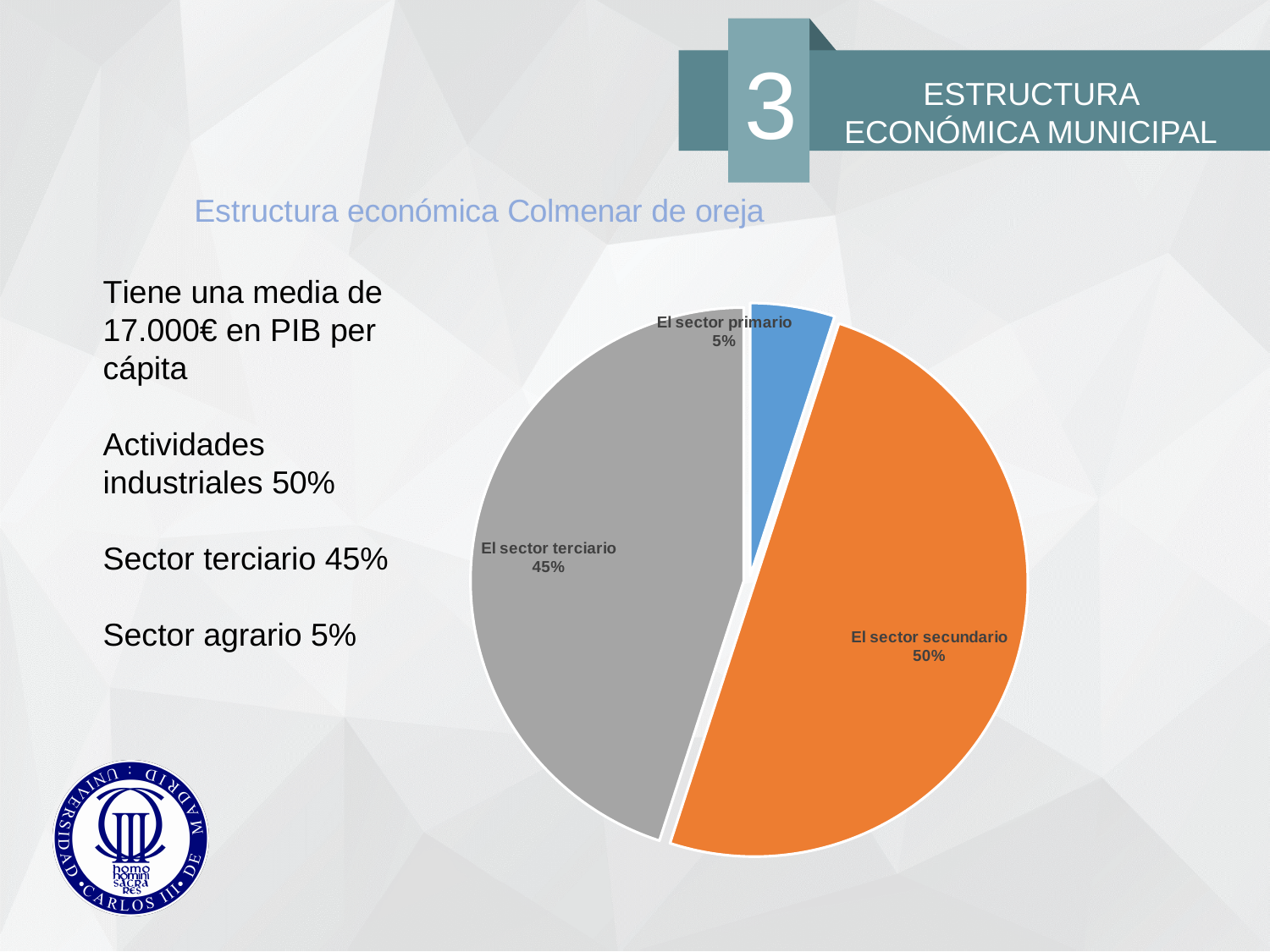
What colour is the slice for El sector terciario? grey What share of the pie does El sector secundario have? 50% What share of the pie does El sector terciario have? 45% What is the difference in percentage points between El sector terciario and El sector primario? 40 What is the difference in percentage points between El sector secundario and El sector terciario? 5 Which sector has the largest slice of the pie? El sector secundario Which is larger, El sector secundario or El sector primario? El sector secundario Which sector has the smallest slice of the pie? El sector primario What share of the pie does El sector primario have? 5% What kind of chart is shown on the slide? pie chart How many slices does the pie chart have? 3 What colour is the slice for El sector primario? blue